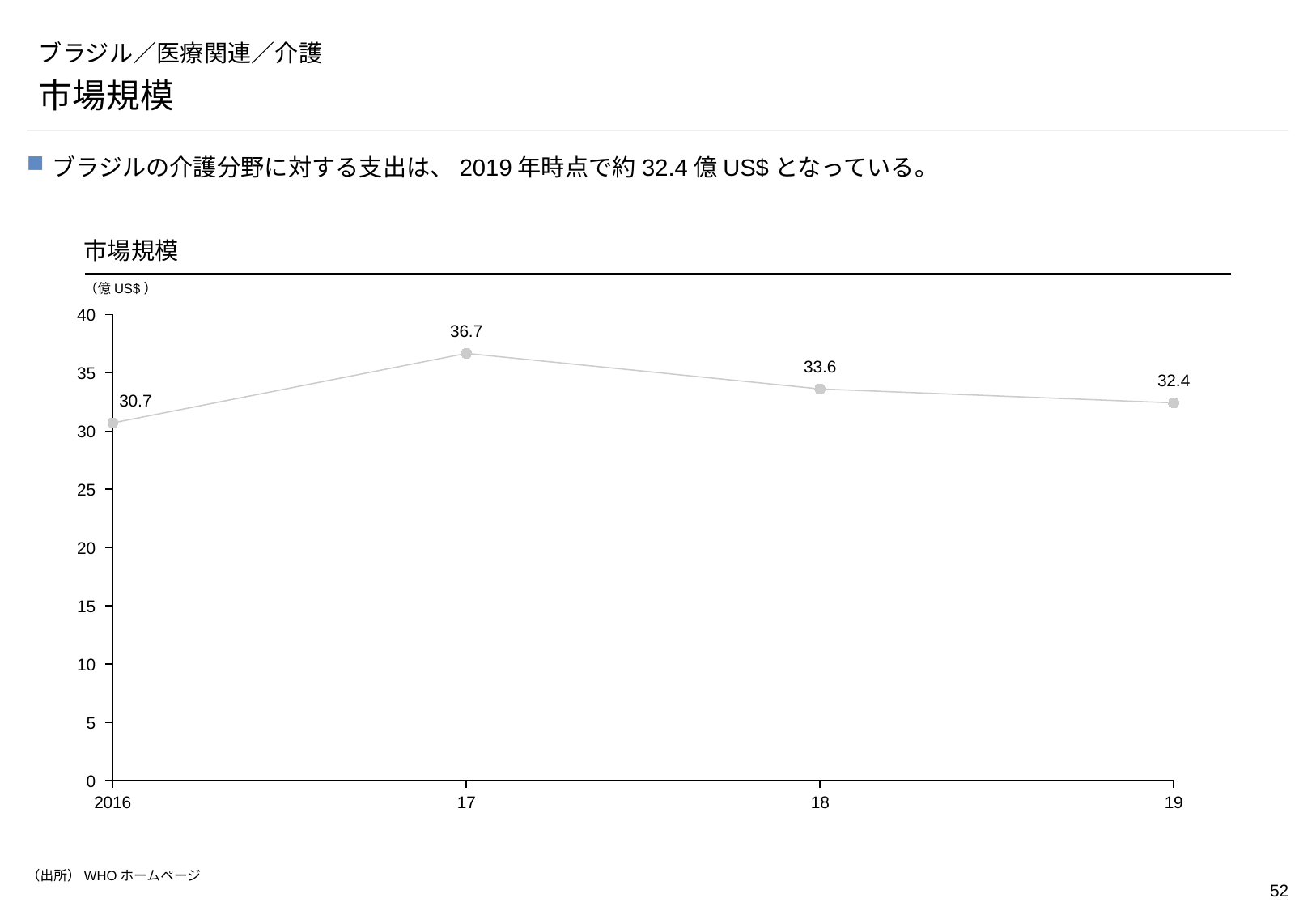
What is the market size value for 2017? 36.7 What is the market size value for 2016? 30.7 Which year has the lowest market size? 2016 Which year has the highest market size? 2017 What unit is shown for the y axis of the chart? 億US$ Is the value for 2017 greater or less than 35? greater What is the difference between the 2017 and 2019 values? 4.3 What is the market size value for 2019? 32.4 What kind of chart is shown on the slide? line chart What is the difference between the 2018 and 2016 values? 2.9 How many data points are plotted on the chart? 4 Which is larger, the value for 2018 or the value for 2019? 2018